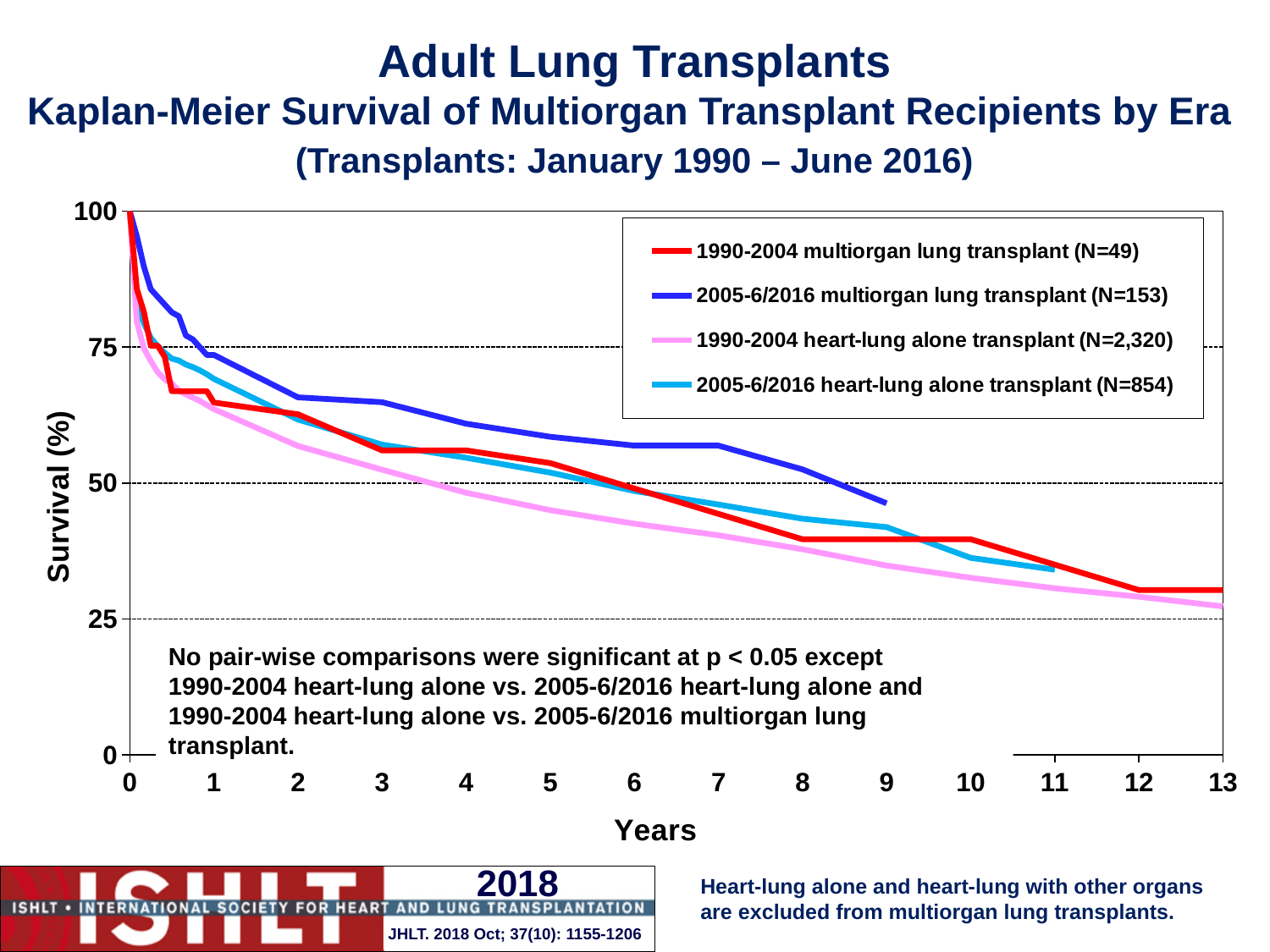
What colour is the line for the 1990-2004 multiorgan lung transplant group? Red What kind of chart is shown on the slide? Line chart Do the survival curves rise or fall as years increase? Fall What is the N for the 1990-2004 heart-lung alone transplant group shown in the legend? N=2,320 Is the survival value for the 1990-2004 heart-lung alone transplant group at 5 years greater or less than 50? less Is the survival value for the 1990-2004 multiorgan lung transplant group at 12 years greater or less than 25? greater Which group in the legend has the smallest N? 1990-2004 multiorgan lung transplant (N=49) Which series has the highest survival at 7 years? 2005-6/2016 multiorgan lung transplant What is the N for the 2005-6/2016 multiorgan lung transplant group shown in the legend? N=153 Is the survival value for the 2005-6/2016 multiorgan lung transplant group at 7 years greater or less than 50? greater Which group in the legend has the largest N? 1990-2004 heart-lung alone transplant (N=2,320) How many series does the legend list? 4